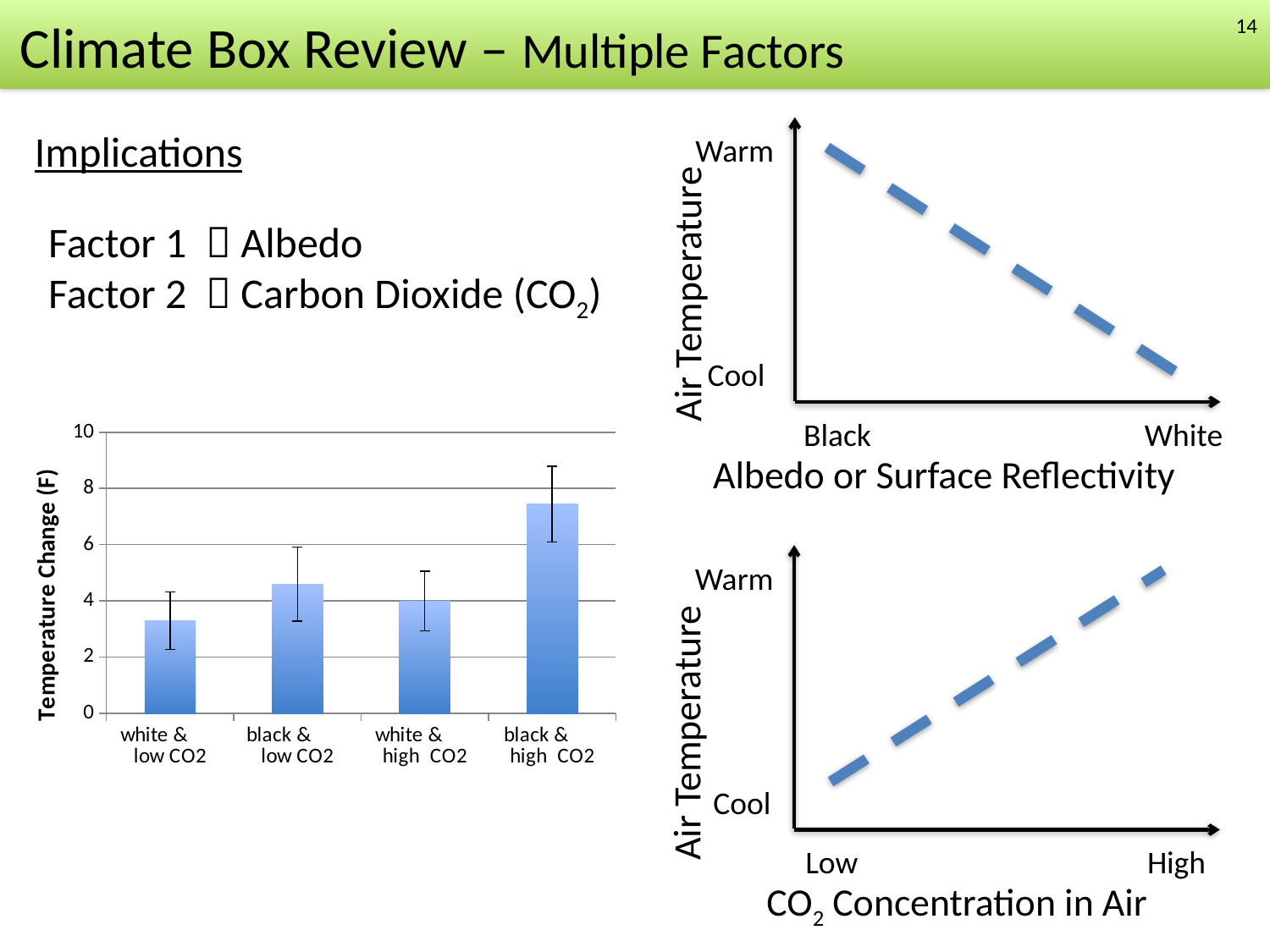
What is the y-axis title of the bottom-left bar chart? Temperature Change (F) In the bottom-right chart titled 'CO2 Concentration in Air', does air temperature rise or fall as CO2 concentration goes from Low to High? rise In the bottom-left bar chart, which category has the lowest temperature change? white & low CO2 In the bottom-left bar chart, which is larger: the value for black & high CO2 or the value for white & low CO2? black & high CO2 In the bottom-left bar chart, is the value for black & low CO2 greater or less than 4? greater In the bottom-left bar chart, which category has the highest temperature change? black & high CO2 In the top-right chart titled 'Albedo or Surface Reflectivity', does air temperature rise or fall as albedo goes from Black to White? fall What is the y-axis label on the two dashed-line charts on the right side of the slide? Air Temperature In the bottom-left bar chart, is the value for white & low CO2 greater or less than 4? less In the bottom-left bar chart, is the value for black & high CO2 greater or less than 6? greater What kind of chart is the bottom-left chart with the y axis 'Temperature Change (F)'? bar chart How many categories are shown on the x axis of the bottom-left bar chart? 4